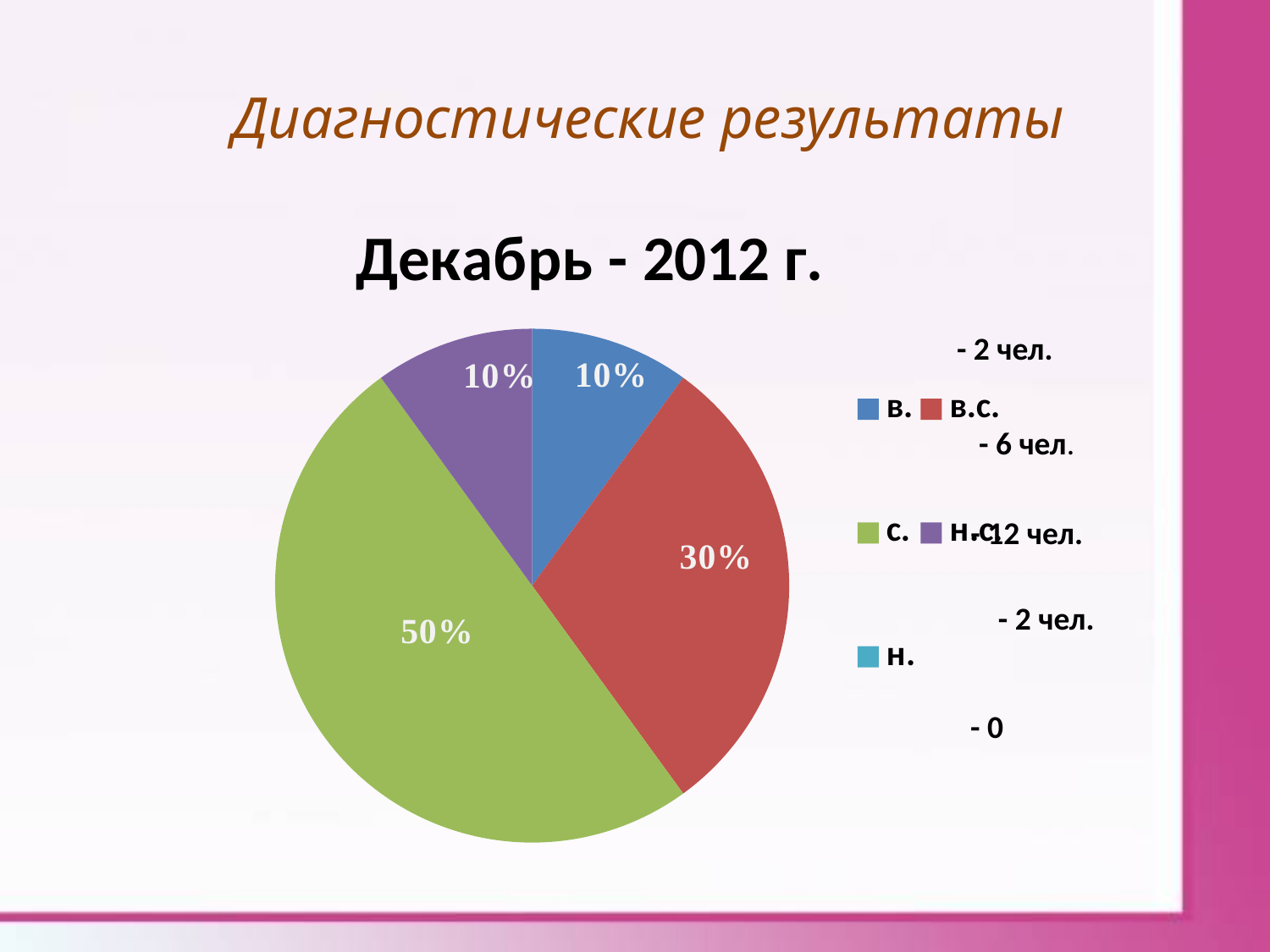
What percentage of the pie does the slice for "в." represent? 10% What is the difference in percentage points between the "с." slice and the "в.с." slice? 20% What colour is the slice for "с."? green How many entries does the legend list? 5 Which is larger, the slice for "в.с." or the slice for "в."? в.с. What percentage of the pie does the slice for "н.с." represent? 10% What kind of chart is shown on the slide? pie chart How many slices are visible in the pie? 4 What is the title of the chart? Декабрь - 2012 г. What percentage of the pie does the slice for "в.с." represent? 30% Which category has the largest slice of the pie? с.